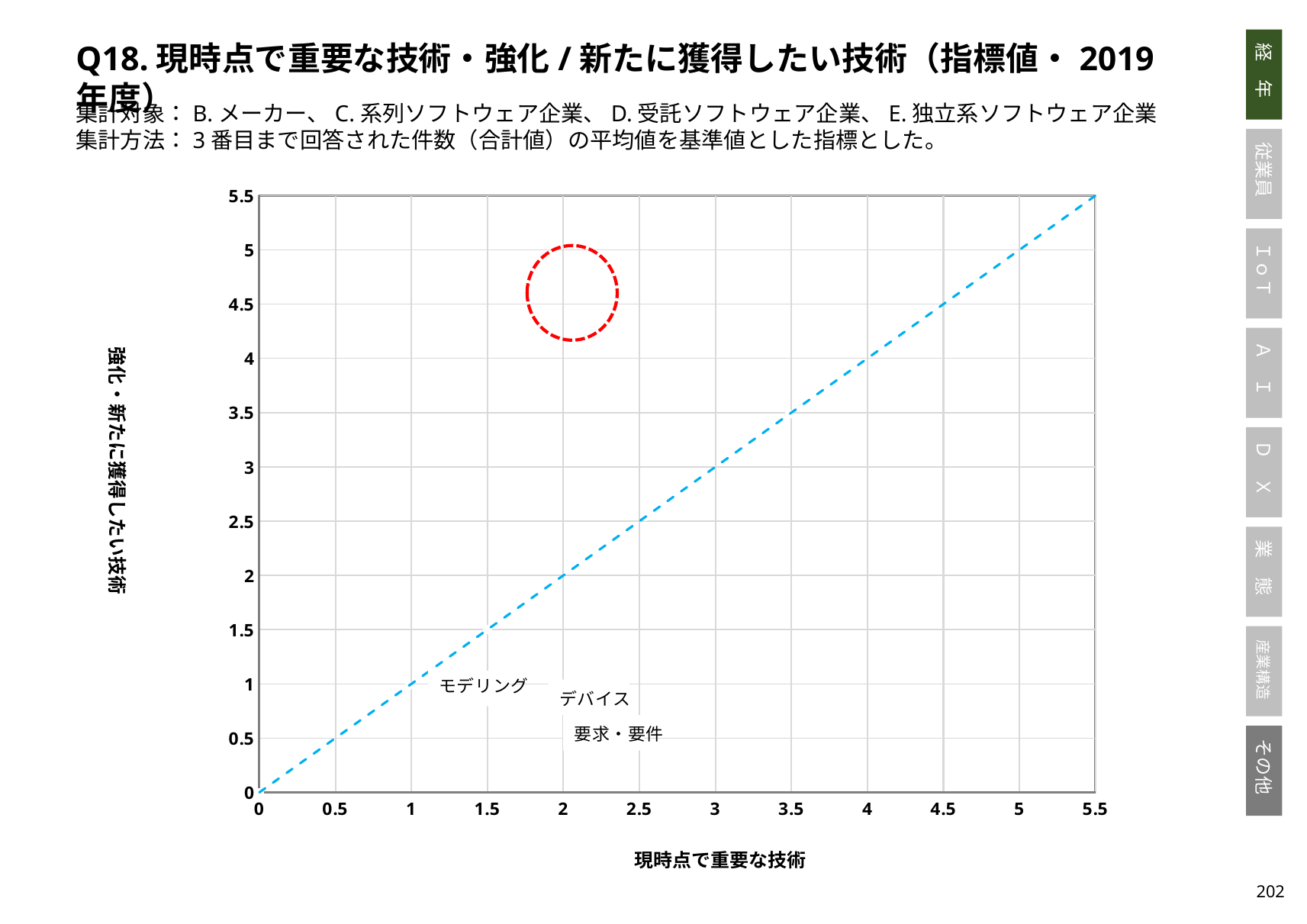
Is the horizontal position of the red dashed circle greater or less than 3? less What is the maximum value shown on the horizontal axis? 5.5 Is the red dashed circle positioned above or below the blue dashed diagonal line? above What is the title of the vertical axis of the chart? 強化・新たに獲得したい技術 Is the vertical position of the red dashed circle greater or less than 4? greater Which of the three labeled technologies appears furthest to the left on the chart? モデリング What is the title of the horizontal axis of the chart? 現時点で重要な技術 Which of the three labeled technologies appears lowest on the chart? 要求・要件 What is the maximum value shown on the vertical axis? 5.5 How many technology labels are plotted on the chart? 3 What kind of chart is shown on the slide? scatter chart